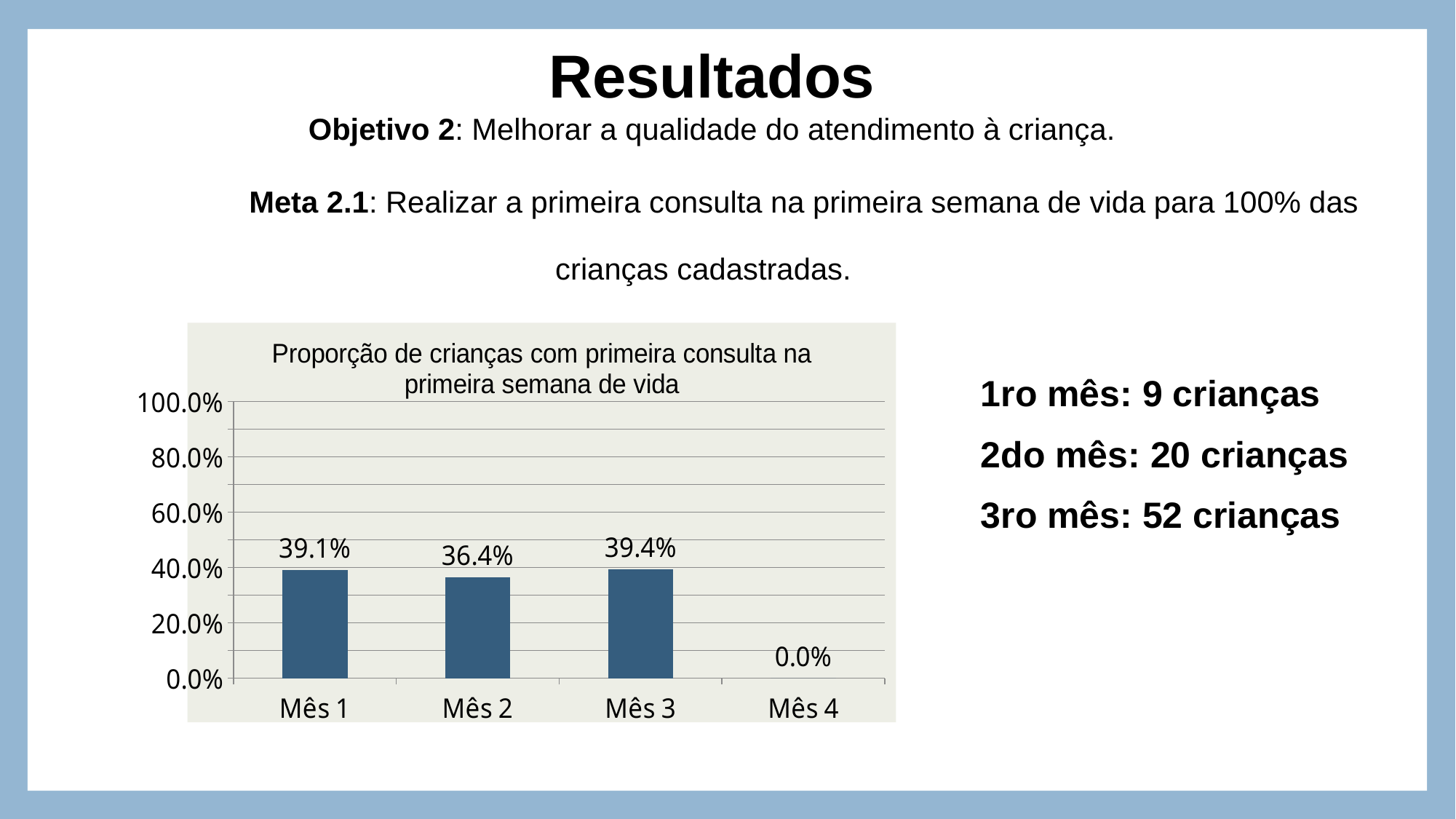
Which is larger, the value for Mês 1 or the value for Mês 2? Mês 1 What is the difference between the values for Mês 1 and Mês 2? 2.7 percentage points What is the value for Mês 3 in the chart? 39.4% What type of chart is shown on the slide? Bar chart How many months (categories) are shown on the x axis of the chart? 4 Which month has the highest value in the chart? Mês 3 Which month has the lowest value in the chart? Mês 4 What is the value for Mês 4 in the chart? 0.0% What is the value for Mês 1 in the chart? 39.1% Is the value for Mês 2 greater or less than 40%? less What is the value for Mês 2 in the chart? 36.4% What is the title of the chart? Proporção de crianças com primeira consulta na primeira semana de vida